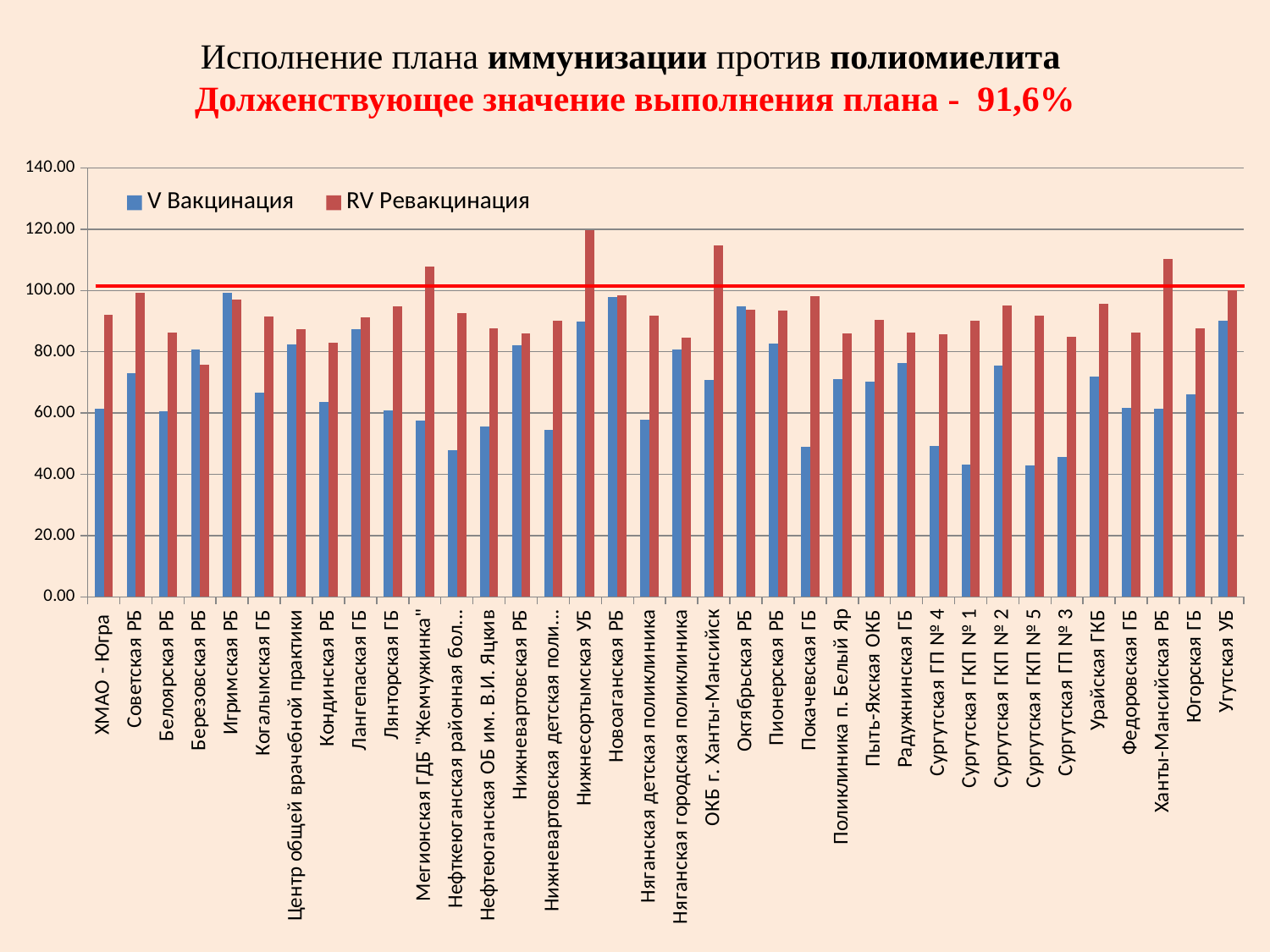
What are the two series named in the legend? V Вакцинация and RV Ревакцинация Which category has the lowest RV Ревакцинация value? Березовская РБ What kind of chart is shown on the slide? bar chart Is the RV Ревакцинация value for ОКБ г. Ханты-Мансийск greater or less than 100.00? greater How many categories (institutions) are shown on the x axis? 36 For Советская РБ, which is larger: V Вакцинация or RV Ревакцинация? RV Ревакцинация Which category has the highest RV Ревакцинация value? Нижнесортымская УБ Is the RV Ревакцинация value for Нижнесортымская УБ greater or less than 100.00? greater Is the V Вакцинация value for Покачевская ГБ greater or less than 60.00? less What target value for plan fulfilment is stated in the slide title? 91,6% How many series does the legend list? 2